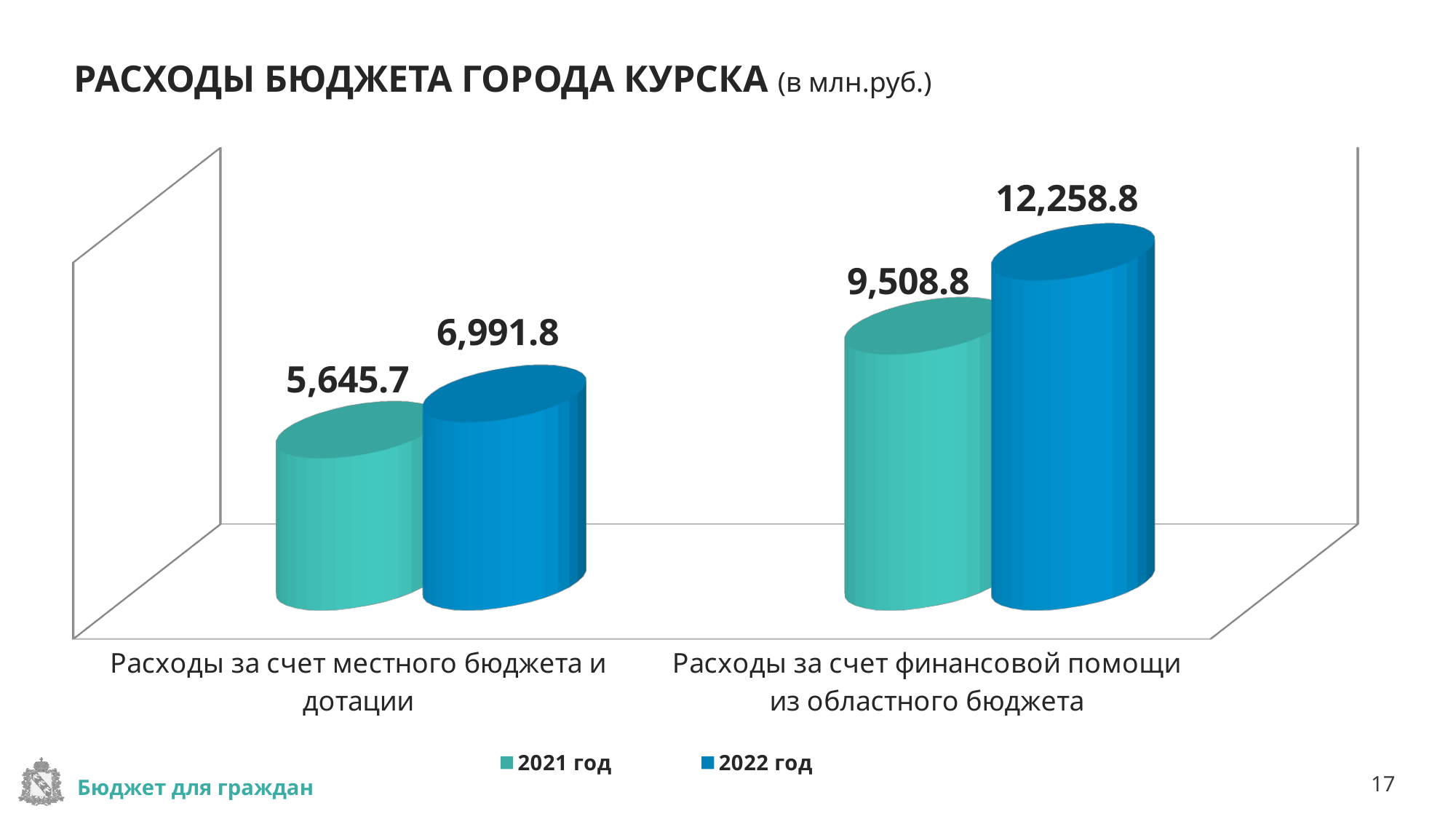
What kind of chart is shown on the slide? Bar chart What is the 2022 год value for «Расходы за счет местного бюджета и дотации»? 6,991.8 By how much did «Расходы за счет финансовой помощи из областного бюджета» increase from 2021 год to 2022 год? 2,750.0 Which is larger: the 2021 год value for «Расходы за счет финансовой помощи из областного бюджета» or the 2022 год value for «Расходы за счет местного бюджета и дотации»? 2021 год value for «Расходы за счет финансовой помощи из областного бюджета» How many categories are shown on the x axis? 2 What is the 2022 год value for «Расходы за счет финансовой помощи из областного бюджета»? 12,258.8 What is the difference between the 2022 год and 2021 год values for «Расходы за счет местного бюджета и дотации»? 1,346.1 Which bar has the highest value on the chart? 2022 год, Расходы за счет финансовой помощи из областного бюджета Which bar has the lowest value on the chart? 2021 год, Расходы за счет местного бюджета и дотации How many series does the legend list? 2 What is the 2021 год value for «Расходы за счет финансовой помощи из областного бюджета»? 9,508.8 What is the 2021 год value for «Расходы за счет местного бюджета и дотации»? 5,645.7